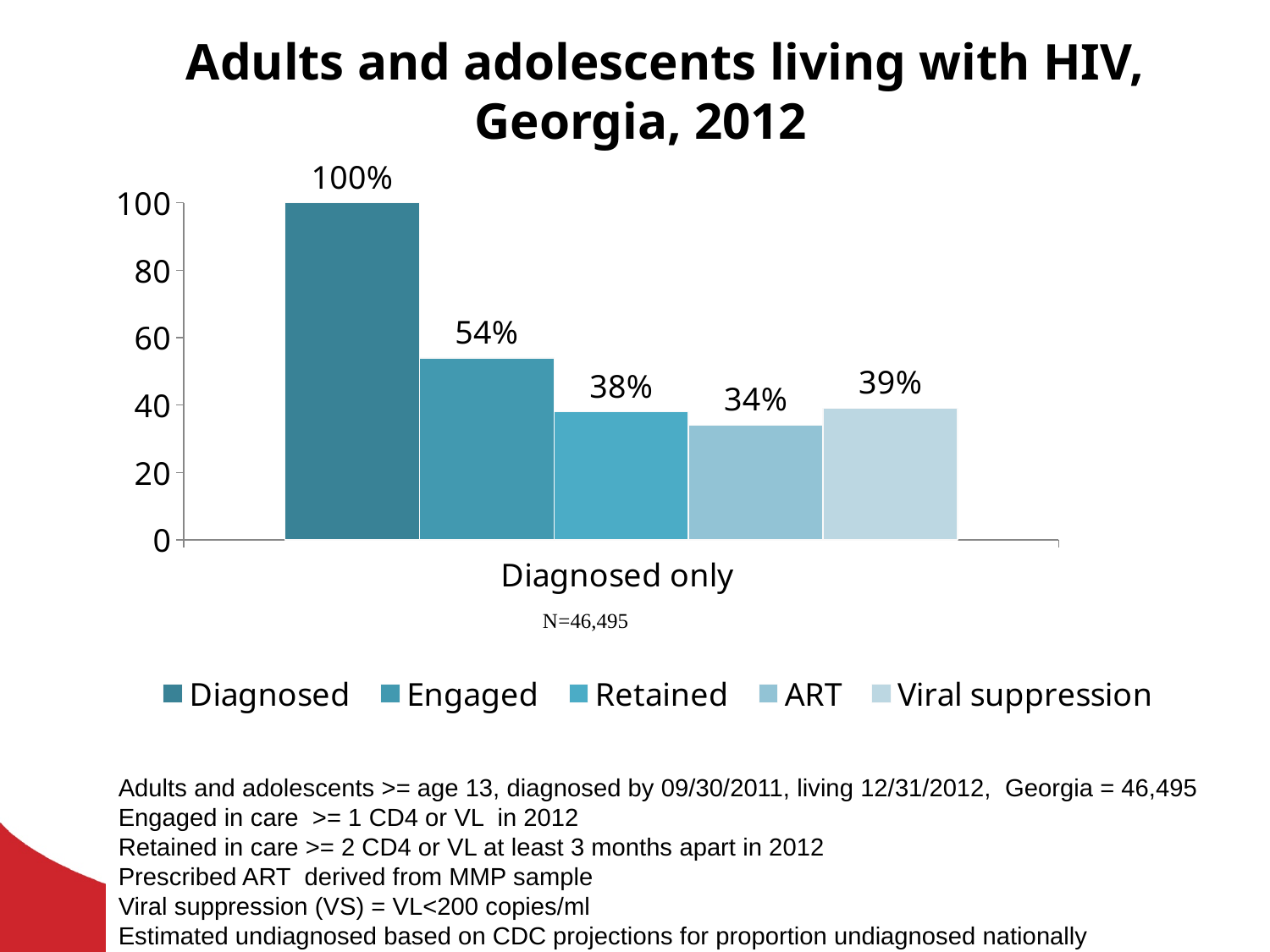
What is the value for Retained? 38% What kind of chart is shown on the slide? Bar chart What is the value for Diagnosed? 100% What is the value for ART? 34% What is the title of the chart? Adults and adolescents living with HIV, Georgia, 2012 What is the difference between the Diagnosed and Engaged values? 46% What is the value for Viral suppression? 39% Which series has the highest value? Diagnosed How many series does the legend list? 5 Which series has the lowest value? ART Which is larger, the value for Retained or the value for ART? Retained What is the value for Engaged? 54%